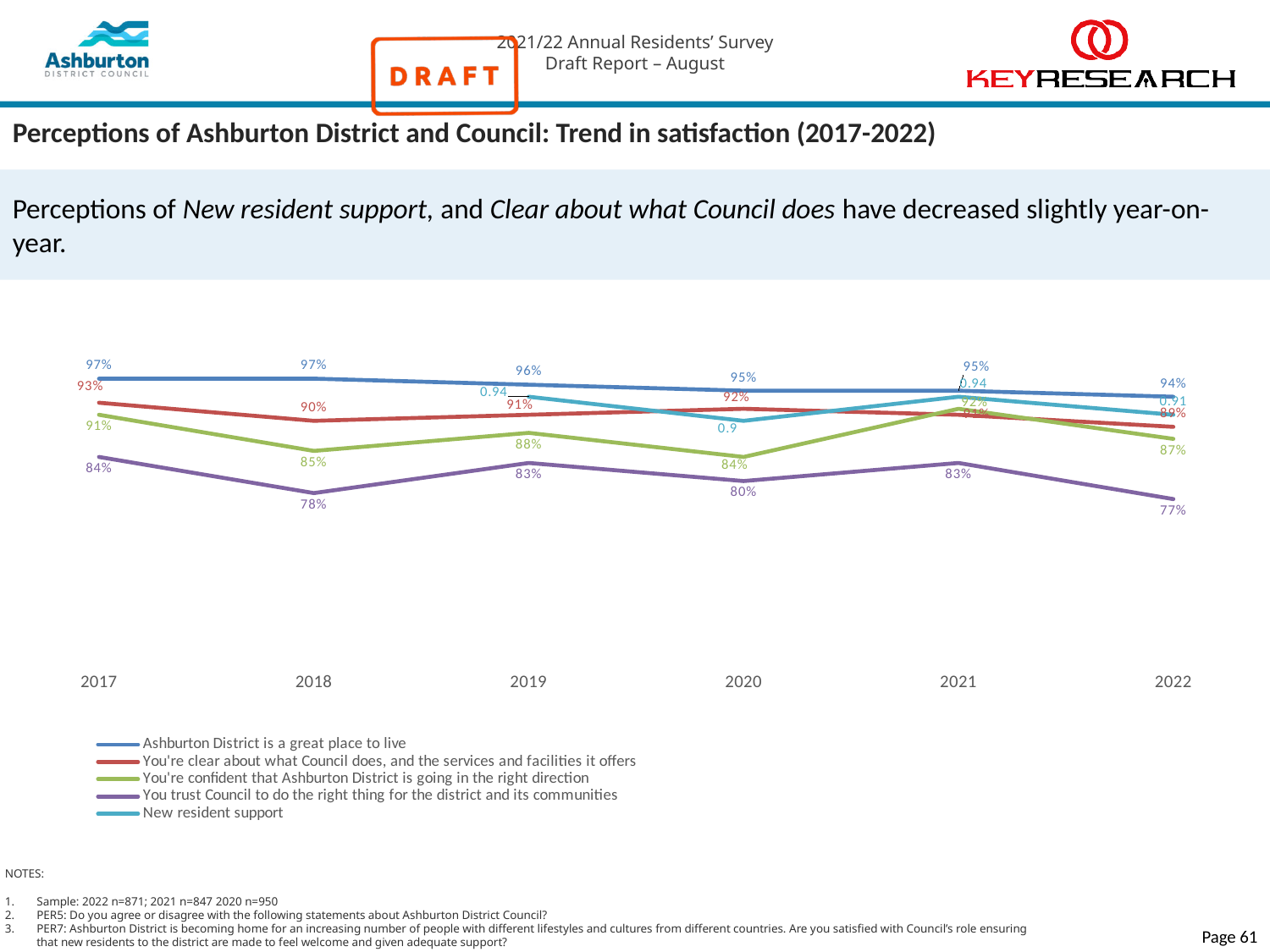
What is the value for 'New resident support' in 2020? 0.9 What is the value for 'You trust Council to do the right thing for the district and its communities' in 2018? 78% What type of chart is shown on the slide? Line chart In which year is 'You trust Council to do the right thing for the district and its communities' at its lowest? 2022 How many years are shown on the x axis? 6 By how many percentage points did 'Ashburton District is a great place to live' change from 2017 to 2022? 3 percentage points In which year is 'You're confident that Ashburton District is going in the right direction' at its highest? 2021 How many series does the legend list? 5 In 2020, which is higher: 'You're confident that Ashburton District is going in the right direction' or 'You trust Council to do the right thing for the district and its communities'? You're confident that Ashburton District is going in the right direction What is the value for 'You trust Council to do the right thing for the district and its communities' in 2022? 77% Does the 'Ashburton District is a great place to live' line rise or fall from 2017 to 2022? Fall What is the value for 'Ashburton District is a great place to live' in 2017? 97%